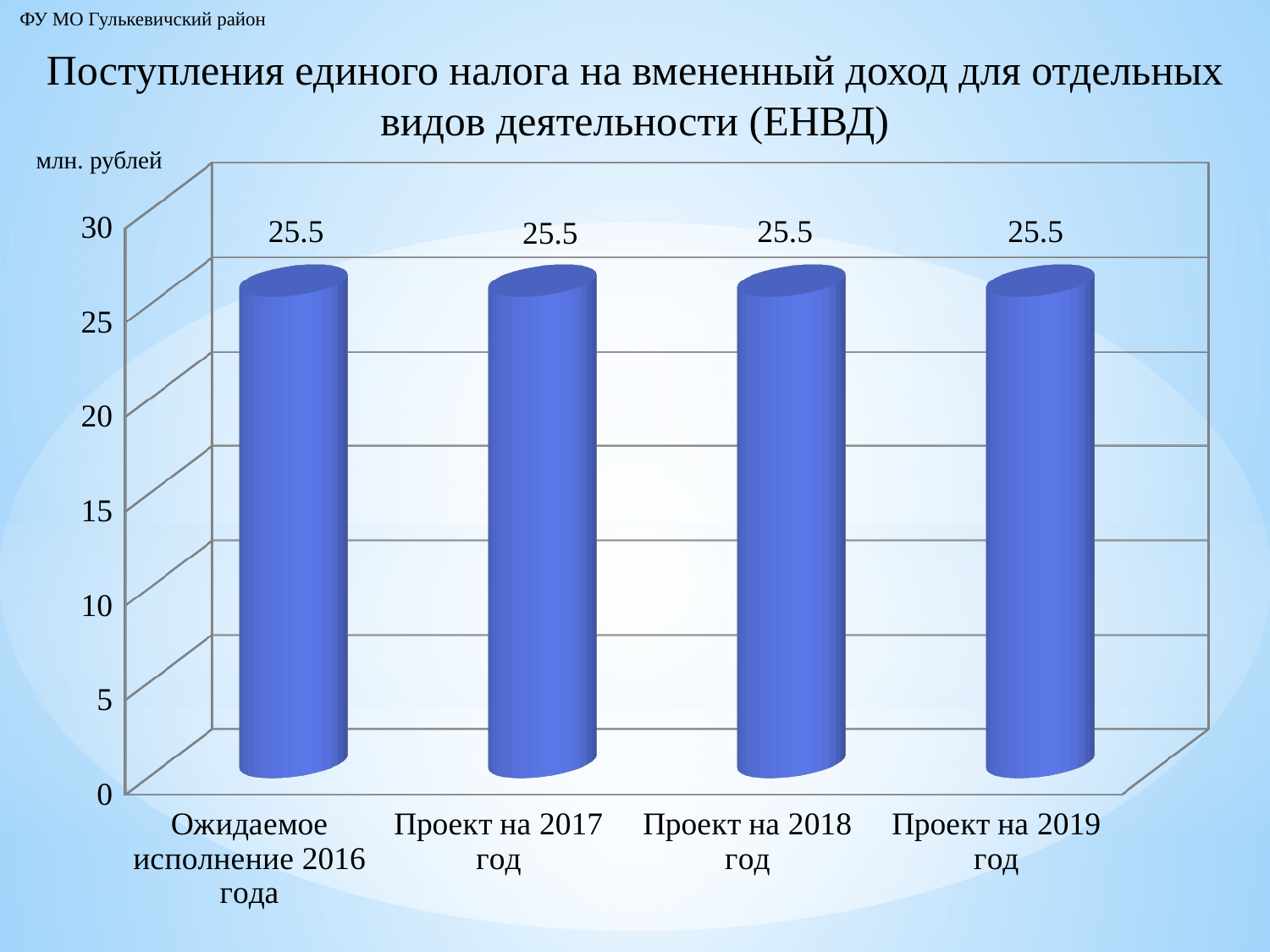
Do the values rise, fall or stay the same from 2016 to 2019? stay the same What is the value for "Проект на 2018 год"? 25.5 In what units are the values on the chart expressed? млн. рублей What is the difference between the value for "Проект на 2019 год" and the value for "Ожидаемое исполнение 2016 года"? 0 What is the value for "Проект на 2019 год"? 25.5 What is the value for "Ожидаемое исполнение 2016 года"? 25.5 What kind of chart is shown on the slide? bar chart How many categories are plotted on the chart? 4 Is the value for "Проект на 2017 год" greater or less than 30? less What is the value for "Проект на 2017 год"? 25.5 Is the value for "Проект на 2018 год" greater or less than 20? greater What is the title of the chart? Поступления единого налога на вмененный доход для отдельных видов деятельности (ЕНВД)